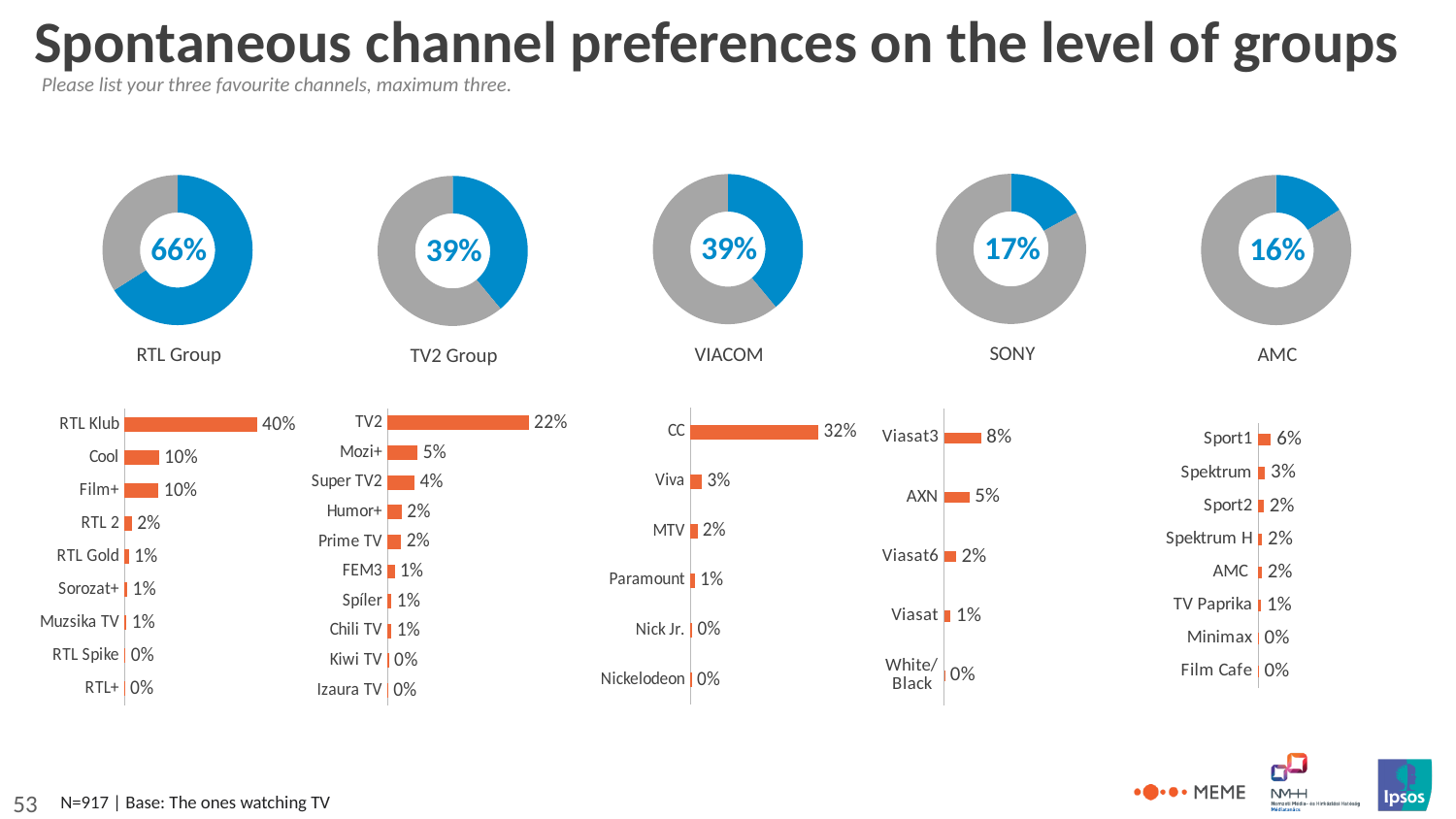
In the SONY bar chart, what is the value for AXN? 5% Among the five donut charts, which group has the lowest percentage? AMC In the TV2 Group bar chart, what is the value for Mozi+? 5% What is the difference between the RTL Group donut value and the AMC donut value? 50 percentage points In the VIACOM bar chart, which channel has the highest value? CC In the SONY donut chart, what percentage is shown? 17% In the AMC bar chart, which channel has the highest value? Sport1 In the TV2 Group bar chart, how many channels are listed? 10 In the RTL Group donut chart, what percentage is shown? 66% In the RTL Group bar chart, what is the value for RTL Klub? 40% What type of chart is used for the channel breakdowns below the donut charts? Bar chart In the VIACOM bar chart, what is the difference between CC and Viva? 29 percentage points